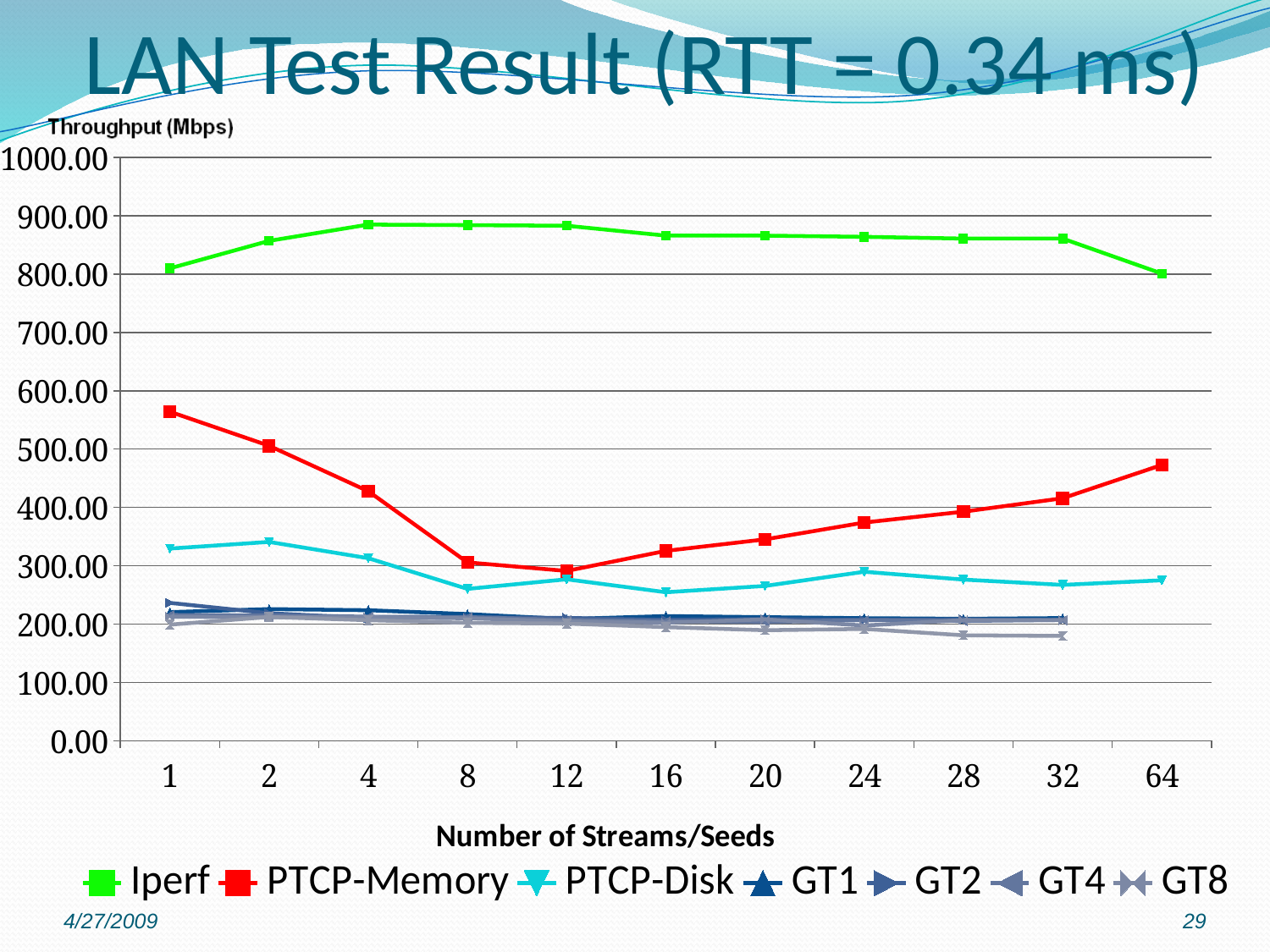
Does the PTCP-Memory throughput rise or fall from 8 streams to 64 streams? rise Is the PTCP-Memory throughput at 1 stream greater or less than 500.00? greater How many series does the legend list? 7 What is the title of the x axis? Number of Streams/Seeds Which series has the highest throughput at 64 streams? Iperf Is the Iperf throughput at 4 streams greater or less than 800.00? greater At 1 stream, which has the higher throughput: Iperf or PTCP-Memory? Iperf Is the PTCP-Memory throughput at 8 streams greater or less than 400.00? less What kind of chart is shown on the slide? line chart What is the label of the y axis? Throughput (Mbps) How many values of Number of Streams/Seeds are plotted along the x axis? 11